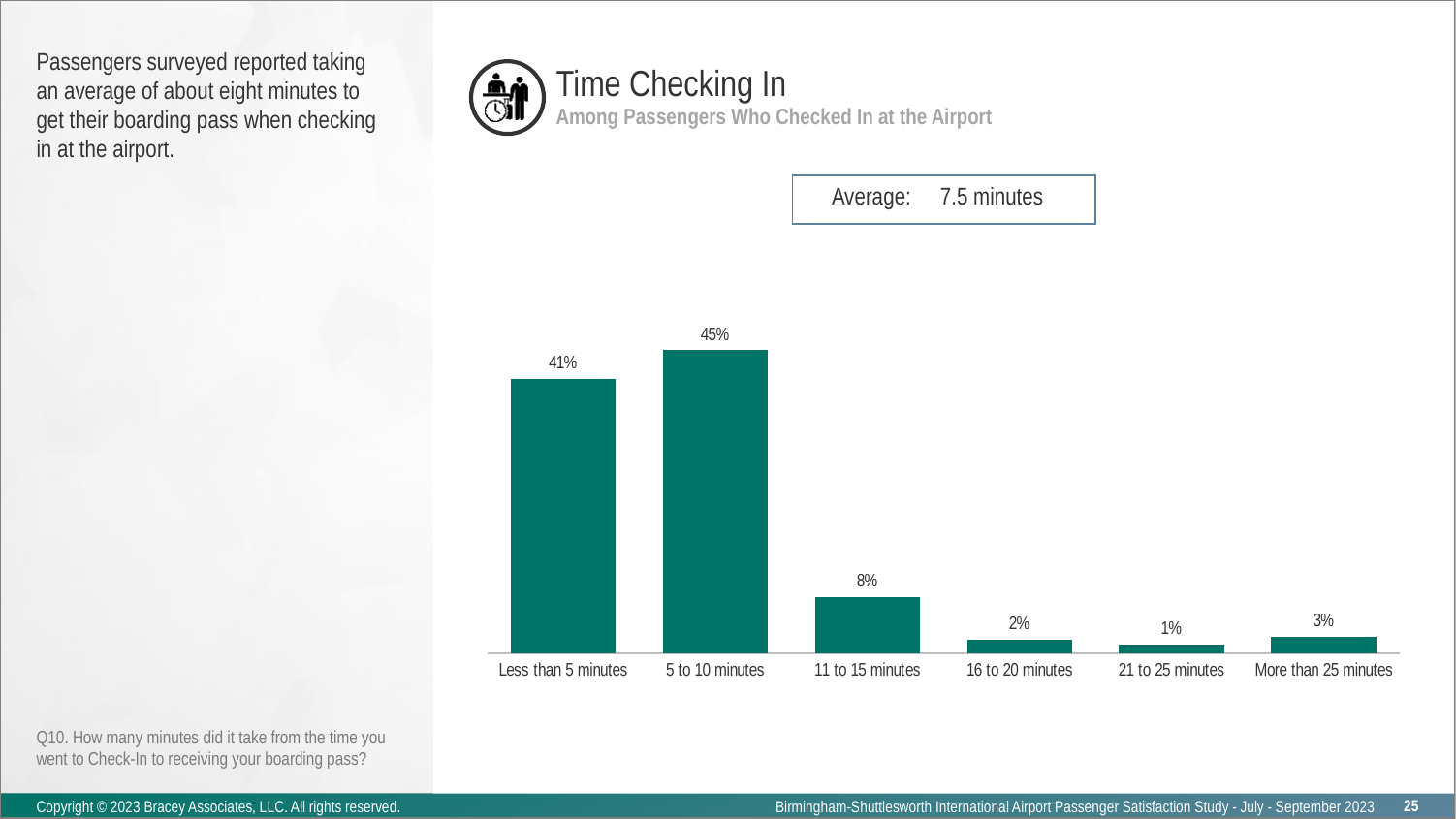
What is the subtitle of the chart? Among Passengers Who Checked In at the Airport What is the average check-in time shown on the slide? 7.5 minutes What percentage of passengers reported a check-in time of 11 to 15 minutes? 8% What type of chart is used to show the time checking in? Bar chart Which check-in time category has the highest percentage? 5 to 10 minutes What percentage of passengers reported a check-in time of more than 25 minutes? 3% Which is larger: the percentage for 16 to 20 minutes or for More than 25 minutes? More than 25 minutes How many check-in time categories are shown in the chart? 6 Which check-in time category has the lowest percentage? 21 to 25 minutes What is the difference in percentage points between the 5 to 10 minutes and Less than 5 minutes categories? 4 What percentage of passengers reported a check-in time of 5 to 10 minutes? 45% What percentage of passengers reported checking in in less than 5 minutes? 41%